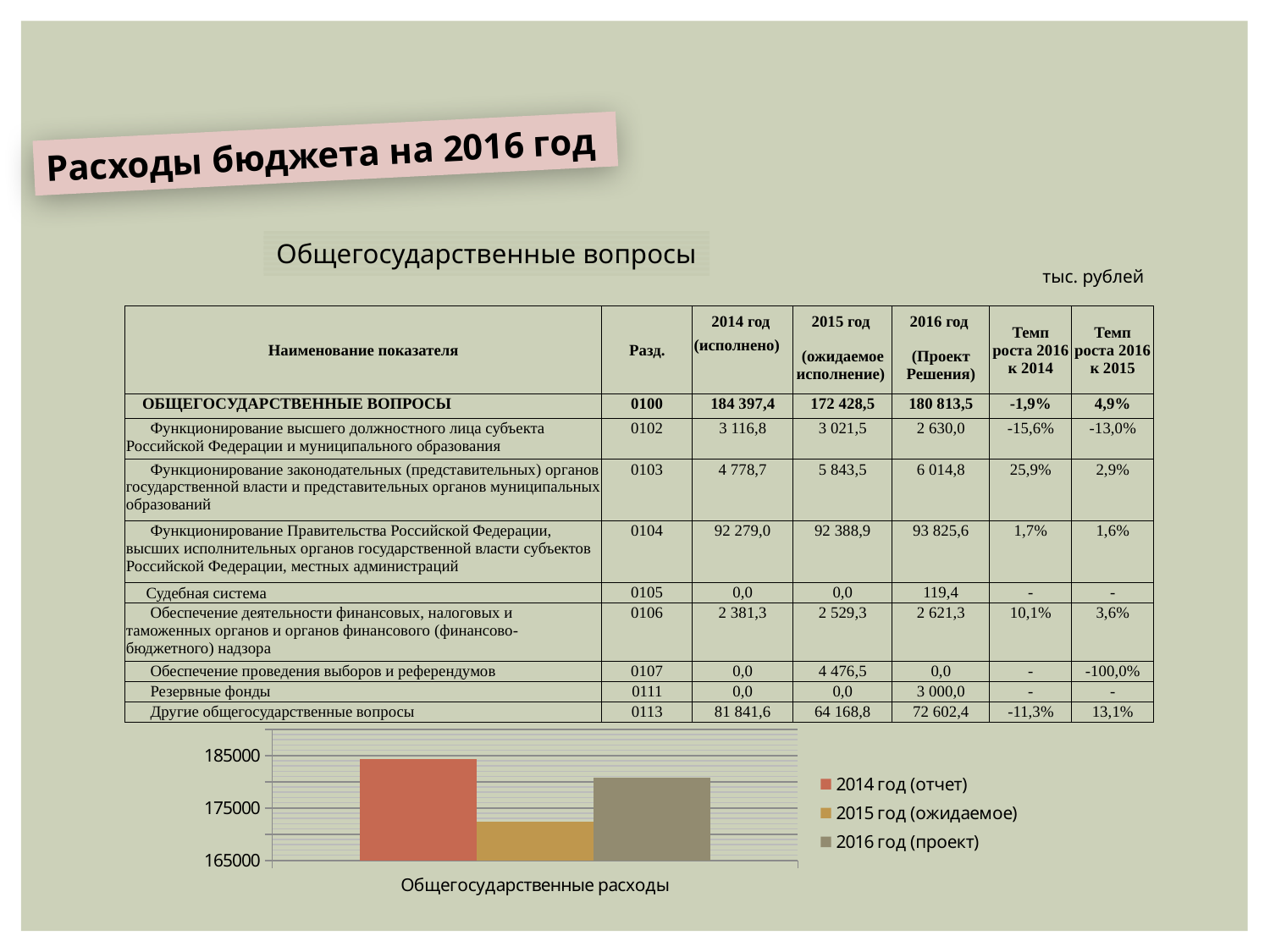
Is the value for 2016 год (проект) greater or less than 175000? greater What kind of chart is shown at the bottom of the slide? bar chart Which series has the highest bar in the chart? 2014 год (отчет) Which is larger in the chart, the bar for 2016 год (проект) or the bar for 2015 год (ожидаемое)? 2016 год (проект) How many categories are shown on the x axis of the chart? 1 Which series has the lowest bar in the chart? 2015 год (ожидаемое) Is the value for 2015 год (ожидаемое) greater or less than 175000? less Which legend entry is shown in red in the chart? 2014 год (отчет) How many series does the legend of the chart list? 3 Is the value for 2014 год (отчет) greater or less than 175000? greater What is the category label on the x axis of the chart? Общегосударственные расходы